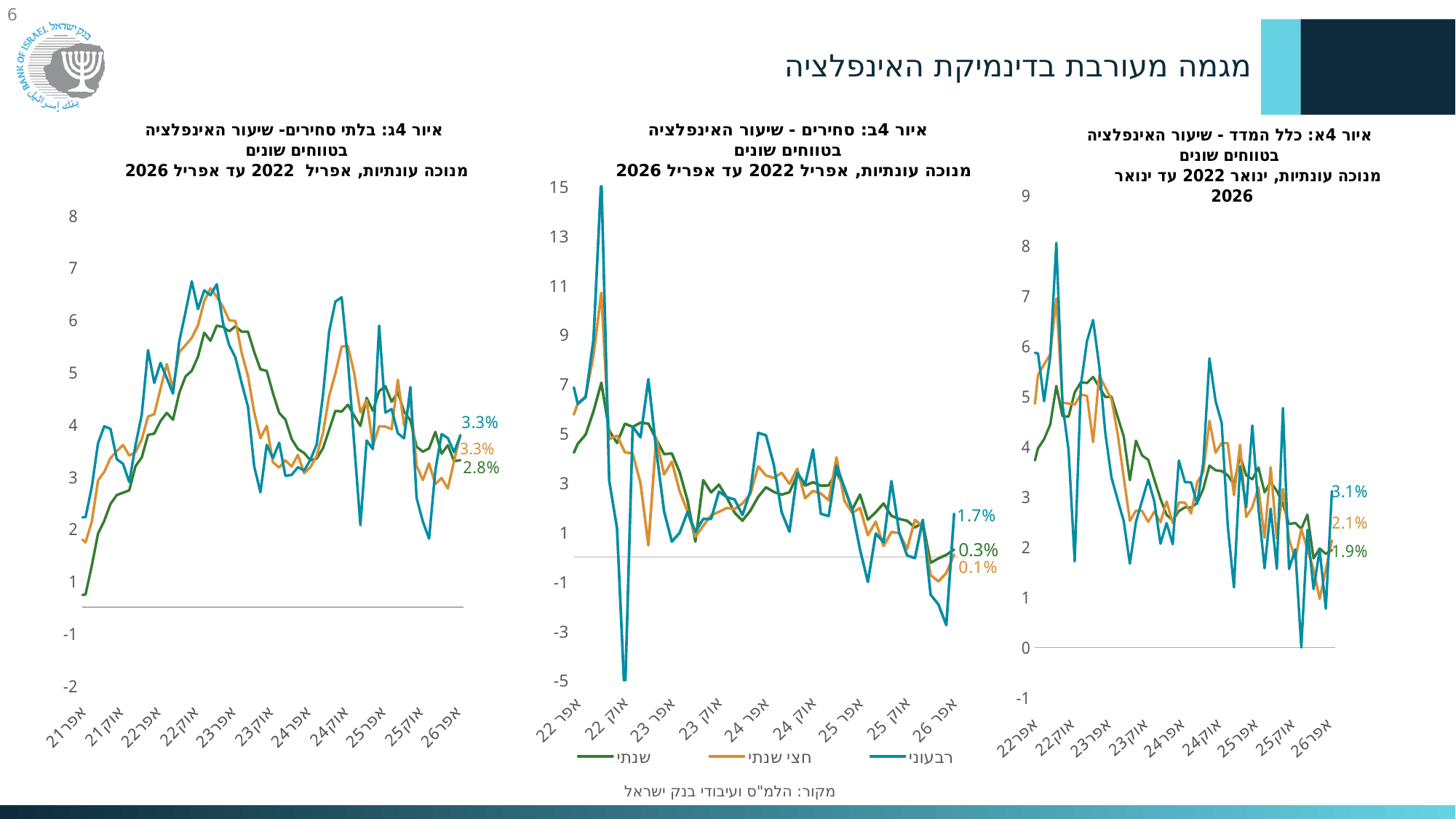
In the right chart (איור 4א), is the highest point of the quarterly (רבעוני) series greater or less than 7? greater How many series does the legend list? 3 In the right chart (איור 4א), what is the final value labelled for the annual (שנתי) series? 1.9% What kind of chart is the middle chart (איור 4ב)? line chart In the right chart (איור 4א), what is the final value labelled for the quarterly (רבעוני) series? 3.1% In the middle chart (איור 4ב), which series has the higher final labelled value, annual (שנתי) or semi-annual (חצי שנתי)? annual (שנתי) In the middle chart (איור 4ב), what is the final value labelled for the semi-annual (חצי שנתי) series? 0.1% In the middle chart (איור 4ב), is the peak of the quarterly (רבעוני) series greater or less than 13? greater In the middle chart (איור 4ב), what is the final value labelled for the quarterly (רבעוני) series? 1.7% In the left chart (איור 4ג), what is the final value labelled for the annual (שנתי) series? 2.8% In the right chart (איור 4א), does the annual (שנתי) series overall rise or fall from 2022 to 2026? fall In the right chart (איור 4א), what is the difference between the final quarterly value and the final annual value? 1.2%